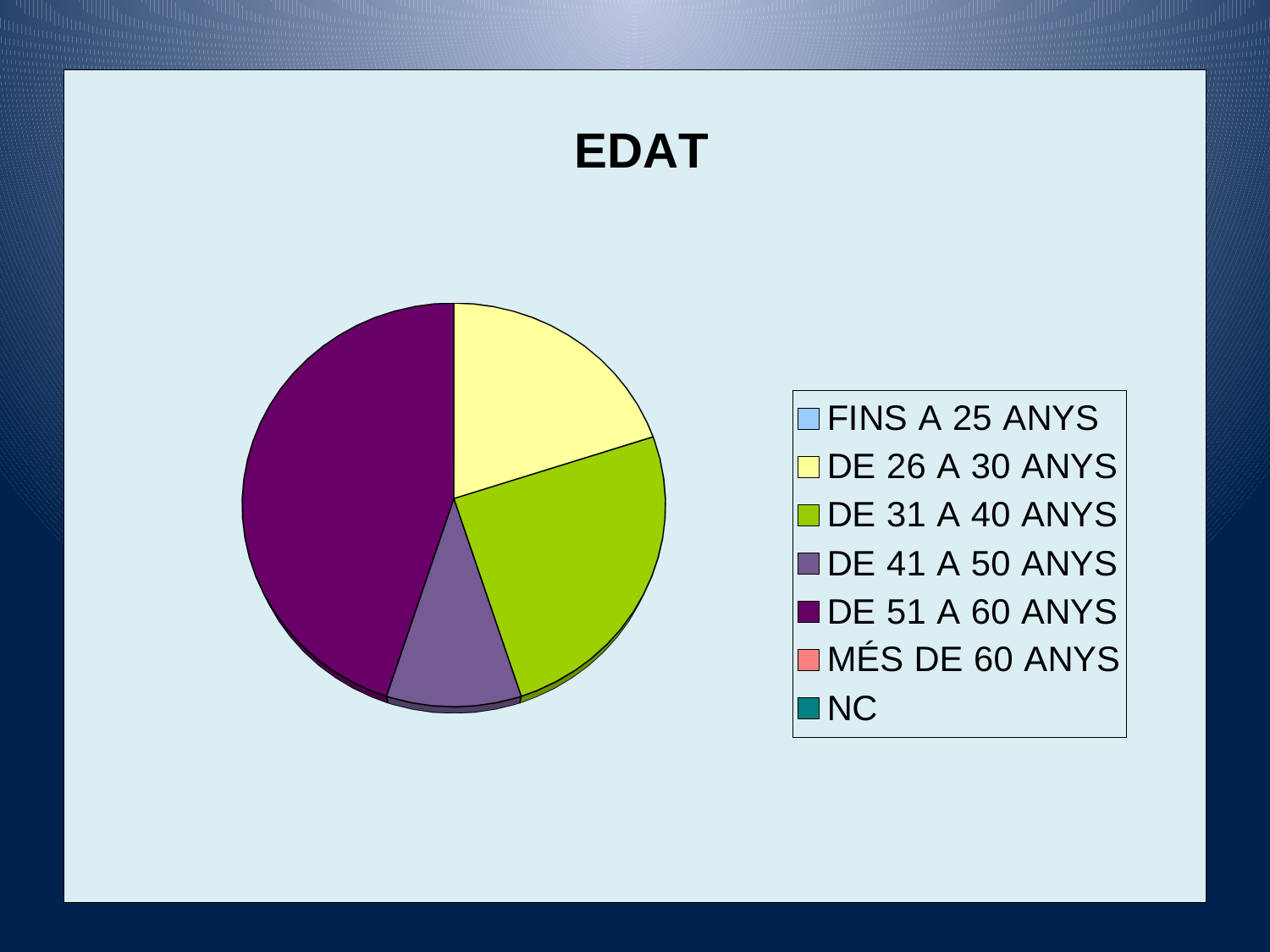
Which slice is larger, DE 51 A 60 ANYS or DE 31 A 40 ANYS? DE 51 A 60 ANYS Which colour represents the DE 51 A 60 ANYS category in the pie? dark purple What is the title of the chart? EDAT How many entries does the chart's legend list? 7 Which slice is larger, DE 31 A 40 ANYS or DE 41 A 50 ANYS? DE 31 A 40 ANYS Which age category has the largest slice of the pie? DE 51 A 60 ANYS Which slice is larger, DE 51 A 60 ANYS or DE 26 A 30 ANYS? DE 51 A 60 ANYS What kind of chart is shown on the slide? pie chart Among the slices visible in the pie, which age category has the smallest slice? DE 41 A 50 ANYS Does the DE 51 A 60 ANYS slice take up more or less than half of the pie? less